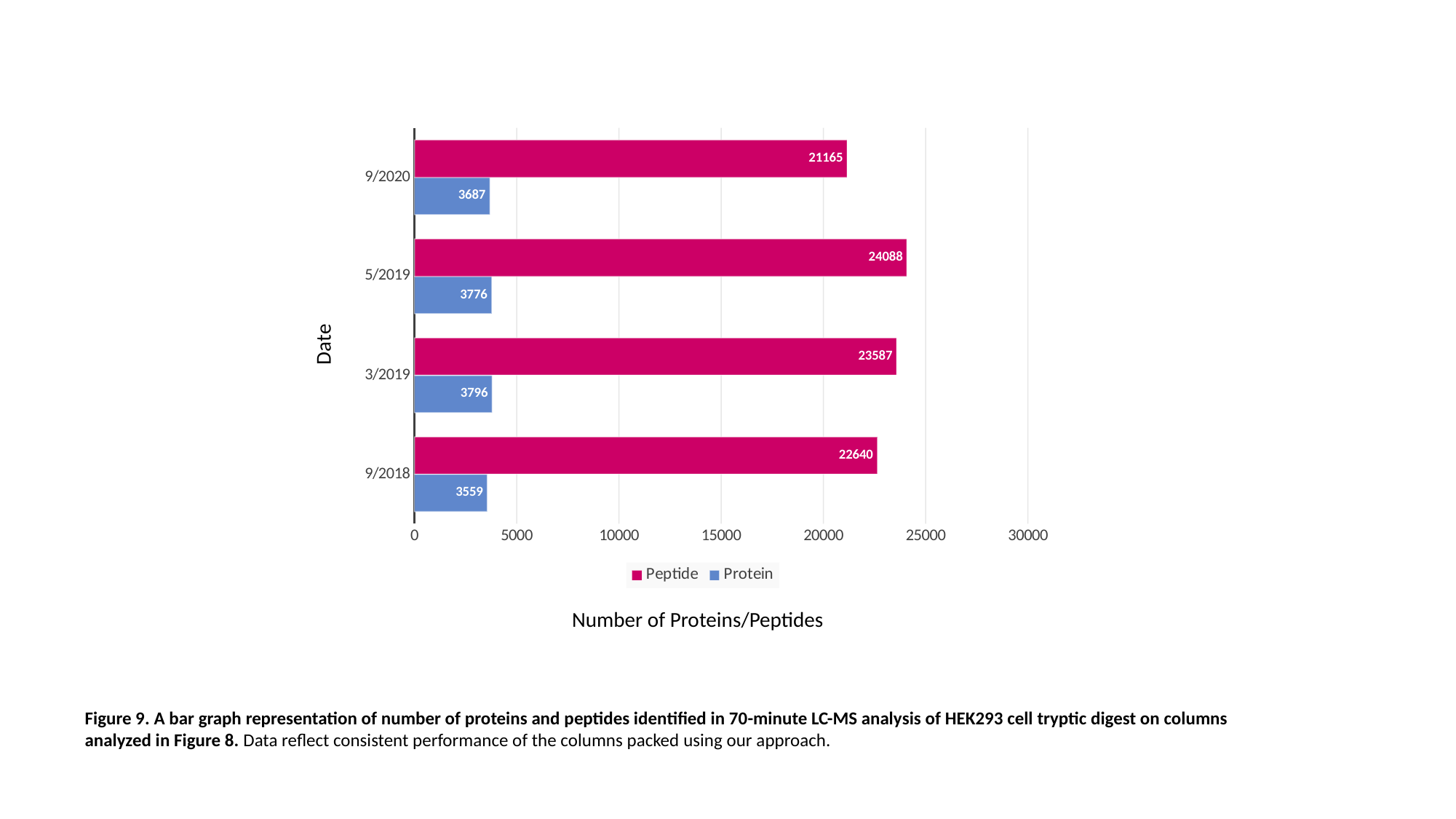
What is the difference between the Peptide values for 5/2019 and 9/2020? 2923 What kind of chart is shown on the slide? bar chart Which is larger, the Peptide value for 3/2019 or the Peptide value for 9/2018? 3/2019 What is the difference between the Protein values for 5/2019 and 9/2018? 217 What is the Peptide value for 9/2020? 21165 What is the Peptide value for 9/2018? 22640 Is the Peptide value for 9/2020 greater or less than 20000? greater How many series does the legend list? 2 Which date has the lowest Protein value? 9/2018 How many dates are shown on the chart? 4 Which date has the highest Peptide value? 5/2019 What is the Protein value for 3/2019? 3796